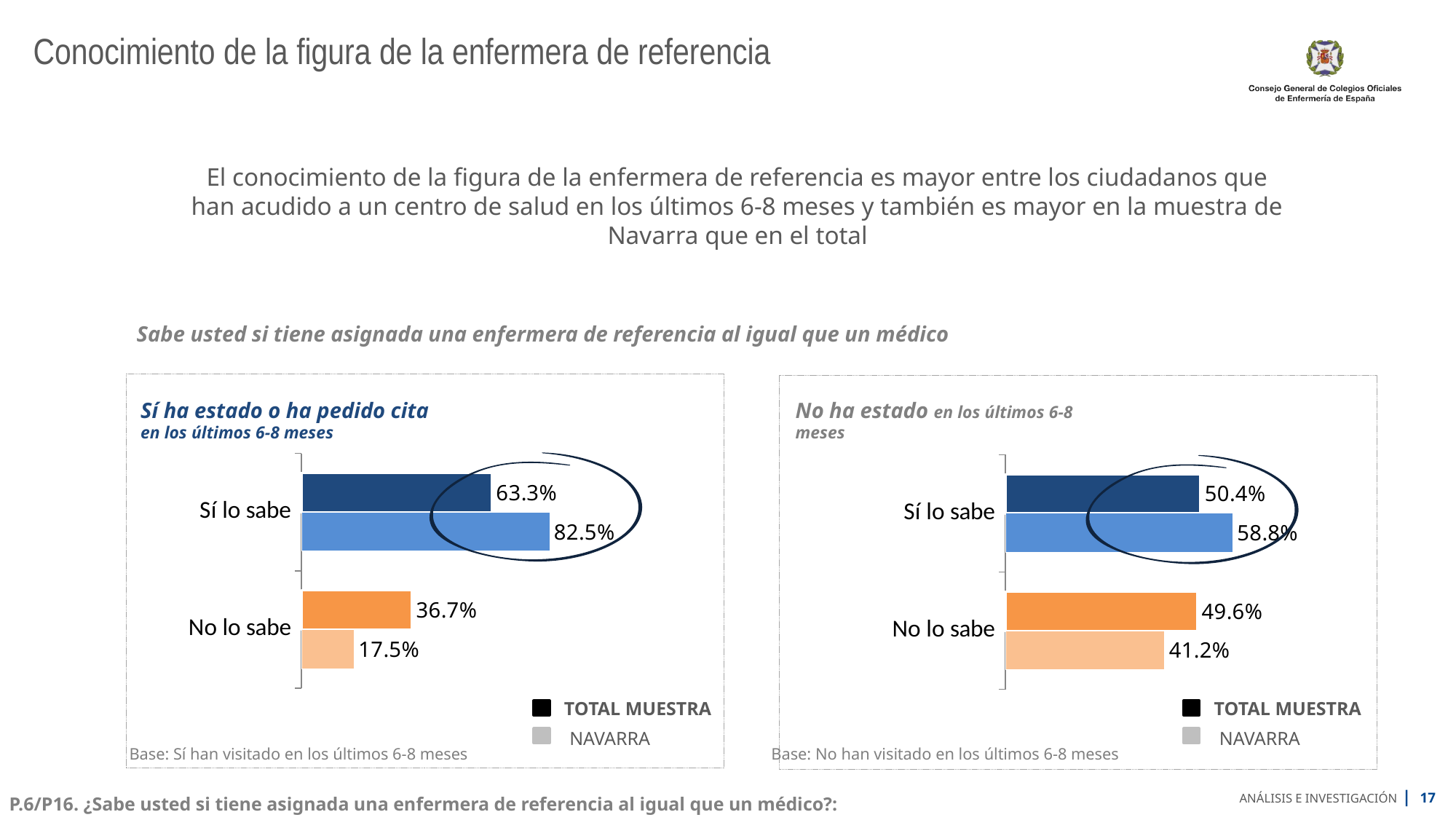
In the right chart (No ha estado en los últimos 6-8 meses), what is the difference between the TOTAL MUESTRA and NAVARRA values for No lo sabe? 8.4% What type of chart is used in the right chart (No ha estado en los últimos 6-8 meses)? Bar chart In the left chart (Sí ha estado o ha pedido cita en los últimos 6-8 meses), what is the value for Sí lo sabe for NAVARRA? 82.5% In the right chart (No ha estado en los últimos 6-8 meses), what is the value for No lo sabe for NAVARRA? 41.2% In the left chart (Sí ha estado o ha pedido cita en los últimos 6-8 meses), what is the difference between the NAVARRA and TOTAL MUESTRA values for Sí lo sabe? 19.2% In the right chart (No ha estado en los últimos 6-8 meses), what is the value for Sí lo sabe for TOTAL MUESTRA? 50.4% In the right chart (No ha estado en los últimos 6-8 meses), which bar has the highest value? Sí lo sabe, NAVARRA (58.8%) In the left chart (Sí ha estado o ha pedido cita en los últimos 6-8 meses), what is the value for No lo sabe for TOTAL MUESTRA? 36.7% What are the two series named in the legend of the right chart? TOTAL MUESTRA and NAVARRA In the left chart (Sí ha estado o ha pedido cita en los últimos 6-8 meses), which bar has the lowest value? No lo sabe, NAVARRA (17.5%) In the right chart (No ha estado en los últimos 6-8 meses), which is larger for Sí lo sabe: TOTAL MUESTRA or NAVARRA? NAVARRA How many series does the legend of the left chart list? 2